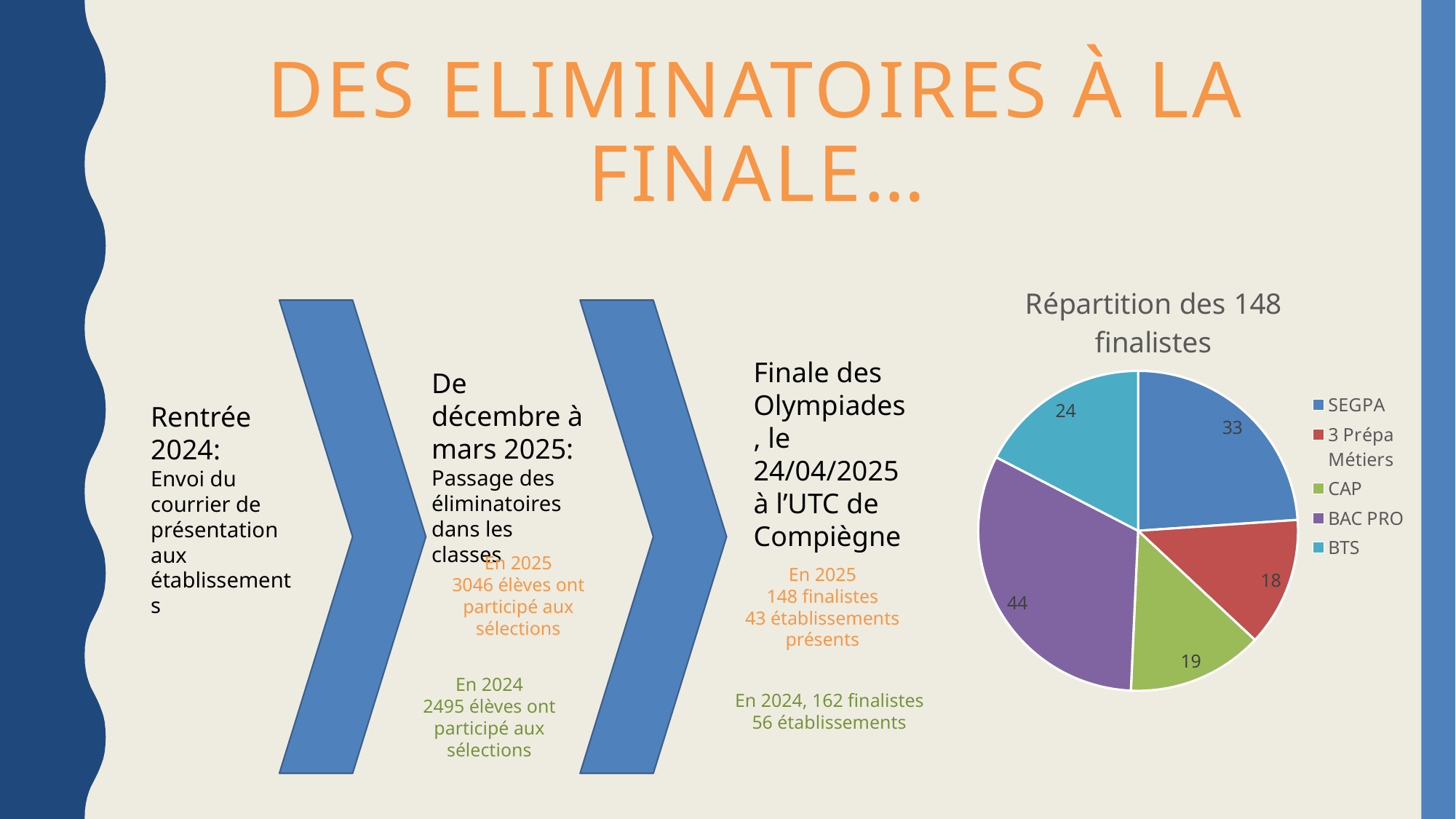
What is the value for SEGPA in the pie chart? 33 What is the value for BAC PRO in the pie chart? 44 What is the value for BTS in the pie chart? 24 What is the difference between the BAC PRO and SEGPA values? 11 Which category has the smallest slice in the pie chart? 3 Prépa Métiers Which category has the largest slice in the pie chart? BAC PRO What is the value for 3 Prépa Métiers in the pie chart? 18 What is the title of the chart? Répartition des 148 finalistes Which colour represents CAP in the pie chart? green What type of chart is shown on the slide? pie chart Which is larger, the value for BTS or the value for CAP? BTS How many categories does the pie chart show? 5